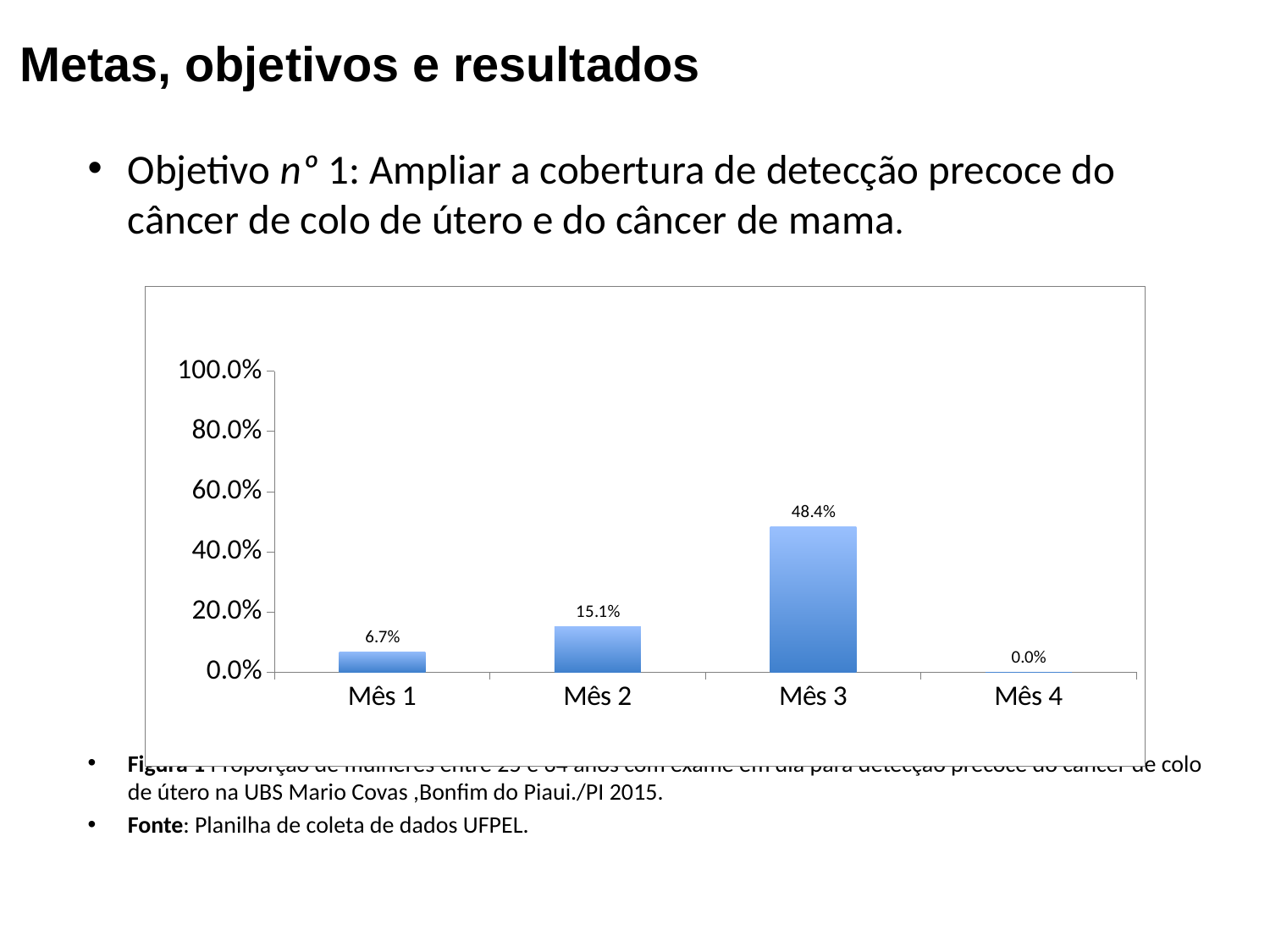
Which month has the highest value? Mês 3 What is the difference between the values for Mês 3 and Mês 2? 33.3% How many months are shown on the x axis? 4 What is the value for Mês 1? 6.7% What kind of chart is shown on the slide? Bar chart What is the highest value shown on the y axis? 100.0% Which is larger, the value for Mês 1 or the value for Mês 2? Mês 2 What is the value for Mês 4? 0.0% What is the value for Mês 3? 48.4% Which month has the lowest value? Mês 4 What is the value for Mês 2? 15.1% Is the value for Mês 3 greater or less than 40.0%? greater